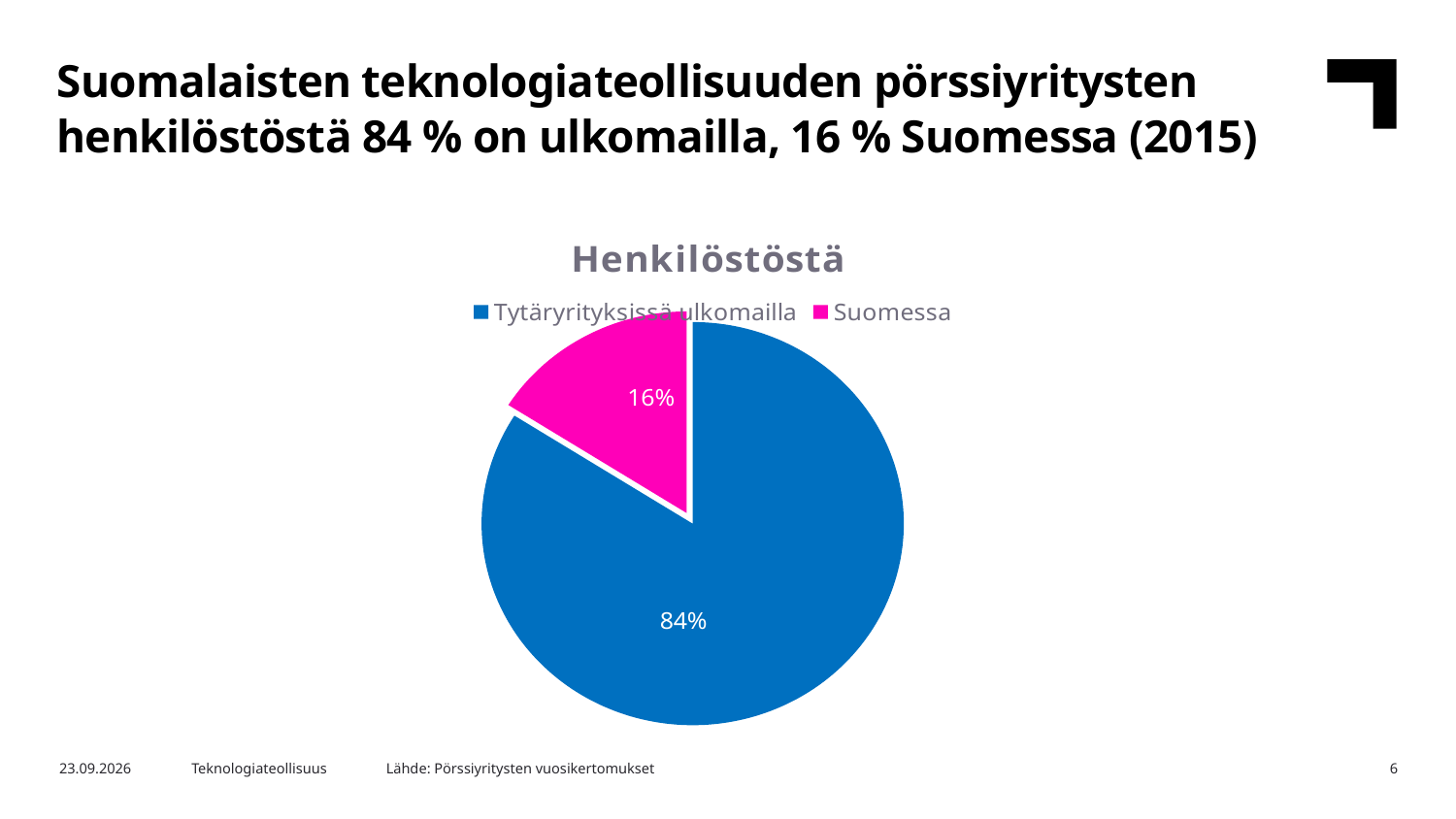
How many entries does the legend list? 2 What kind of chart is shown on the slide? pie chart Which is larger, the Suomessa slice or the Tytäryrityksissä ulkomailla slice? Tytäryrityksissä ulkomailla How many slices does the pie chart have? 2 Which slice is the largest? Tytäryrityksissä ulkomailla What is the chart's title? Henkilöstöstä What is the difference in percentage points between the Tytäryrityksissä ulkomailla slice and the Suomessa slice? 68 Which slice is the smallest? Suomessa What share of the pie does the Tytäryrityksissä ulkomailla slice represent? 84% What share of the pie does the Suomessa slice represent? 16% What colour is the Suomessa slice? magenta